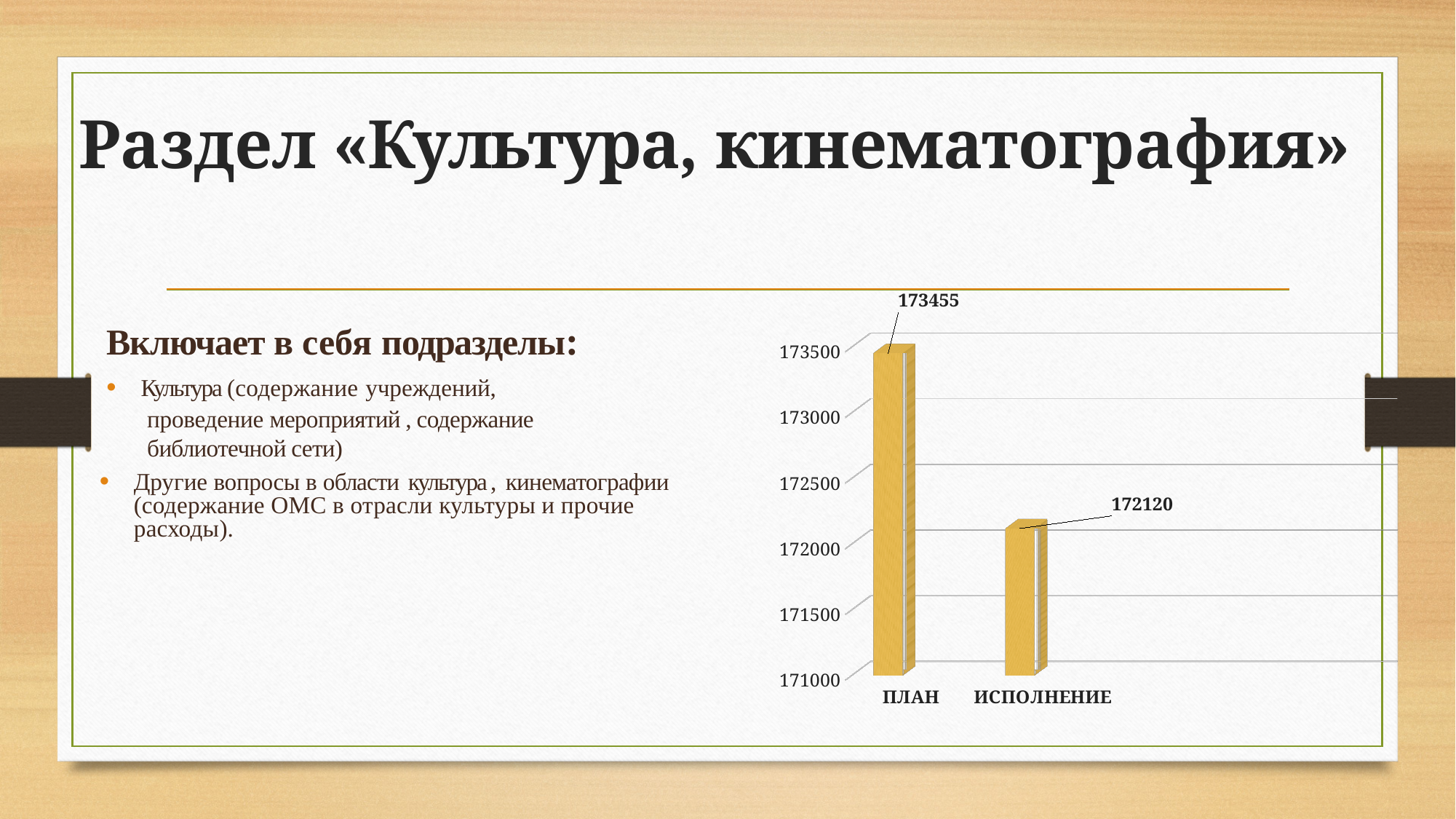
What kind of chart is shown on the slide? bar chart What is the value for ИСПОЛНЕНИЕ? 172120 Which category has the lowest value? ИСПОЛНЕНИЕ What is the lowest value shown on the vertical axis of the chart? 171000 Is the value for ПЛАН greater or less than 173000? greater How many categories are shown on the chart? 2 Is the value for ИСПОЛНЕНИЕ greater or less than 172500? less Which category has the highest value? ПЛАН What is the value for ПЛАН? 173455 Do the values rise or fall from ПЛАН to ИСПОЛНЕНИЕ? fall Which is larger, the value for ПЛАН or the value for ИСПОЛНЕНИЕ? ПЛАН What is the difference between the values for ПЛАН and ИСПОЛНЕНИЕ? 1335